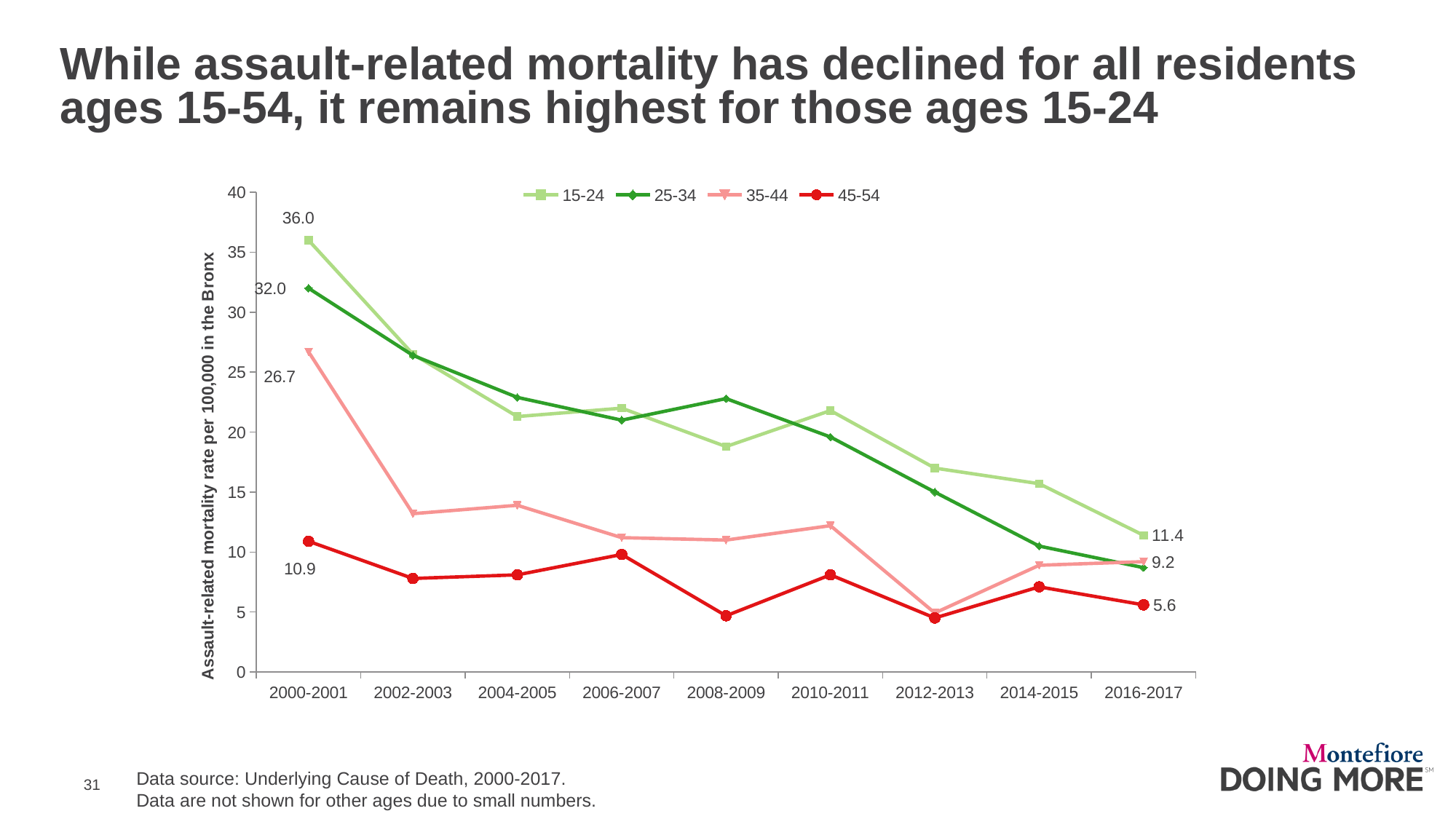
In 2000-2001, which is larger: the rate for ages 35-44 or ages 45-54? 35-44 Does the rate for ages 15-24 generally rise or fall from 2000-2001 to 2016-2017? fall How many series does the legend list? 4 What is the assault-related mortality rate for ages 45-54 in 2016-2017? 5.6 Which age group had the lowest rate in 2000-2001? 45-54 By how much did the rate for ages 15-24 fall from 2000-2001 to 2016-2017? 24.6 Which age group had the highest rate in 2000-2001? 15-24 What is the assault-related mortality rate for ages 15-24 in 2000-2001? 36.0 What is the assault-related mortality rate for ages 25-34 in 2000-2001? 32.0 How many time periods are shown along the x axis? 9 Is the value for ages 25-34 in 2008-2009 greater or less than 20? greater What kind of chart is shown on the slide? line chart